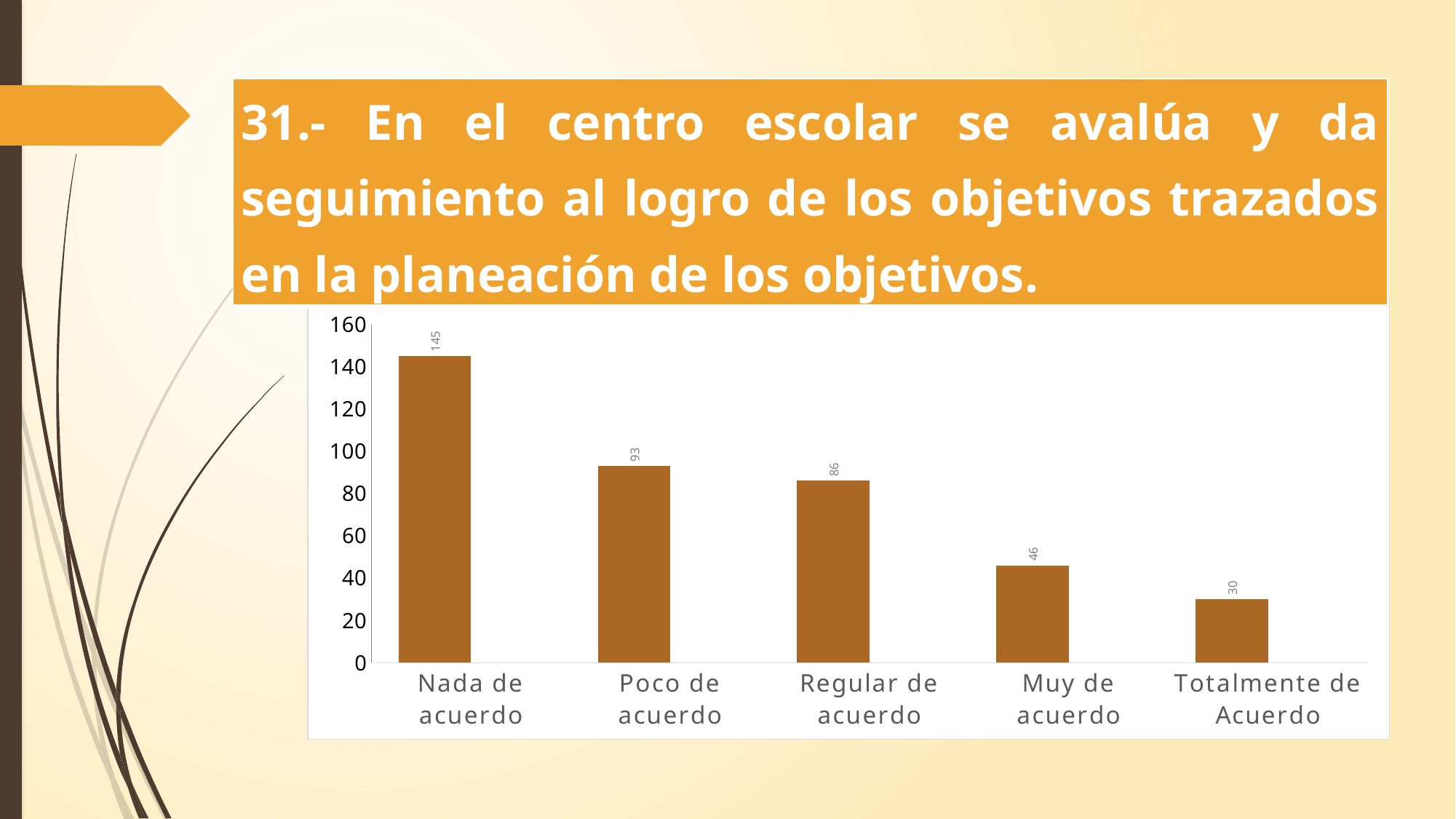
What is the value for "Nada de acuerdo"? 145 What is the value for "Muy de acuerdo"? 46 How many categories are shown on the x axis? 5 What is the value for "Poco de acuerdo"? 93 Which is larger, the value for "Muy de acuerdo" or the value for "Totalmente de Acuerdo"? Muy de acuerdo Which category has the highest value? Nada de acuerdo What kind of chart is shown on the slide? Bar chart What is the difference between the values for "Nada de acuerdo" and "Poco de acuerdo"? 52 What is the value for "Regular de acuerdo"? 86 Do the values rise or fall from left to right along the x axis? Fall What is the value for "Totalmente de Acuerdo"? 30 Which category has the lowest value? Totalmente de Acuerdo